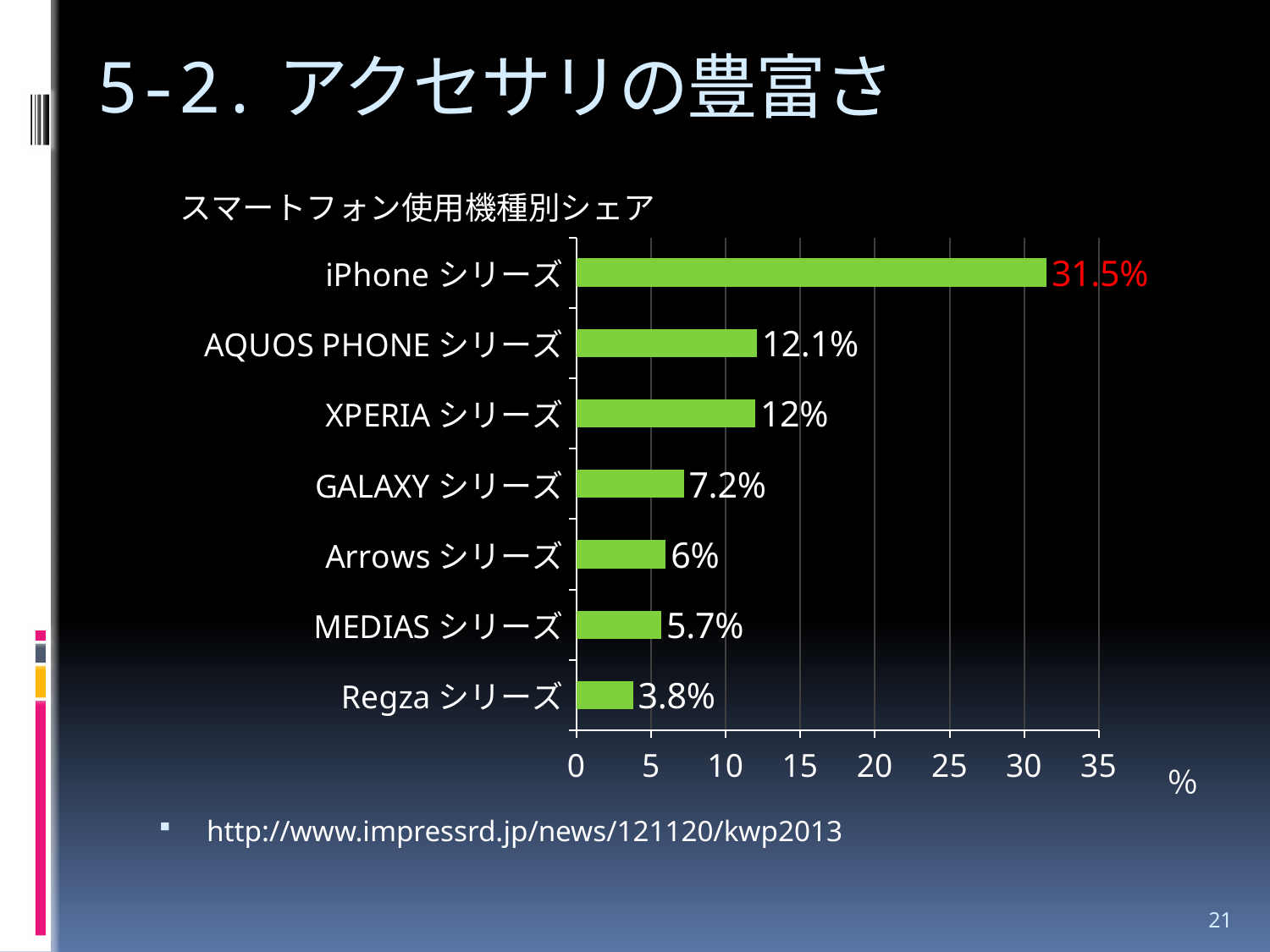
Is the value for XPERIA シリーズ greater or less than 10? greater How many categories are shown in the chart? 7 What is the title of the chart? スマートフォン使用機種別シェア What is the difference between the values for iPhone シリーズ and AQUOS PHONE シリーズ? 19.4% What is the value for GALAXY シリーズ? 7.2% What is the value for iPhone シリーズ? 31.5% Which is larger, the value for GALAXY シリーズ or the value for Arrows シリーズ? GALAXY シリーズ Which category has the highest value? iPhone シリーズ Which category has the lowest value? Regza シリーズ What is the value for Regza シリーズ? 3.8% What kind of chart is shown on the slide? bar chart What is the difference between the values for Arrows シリーズ and MEDIAS シリーズ? 0.3%